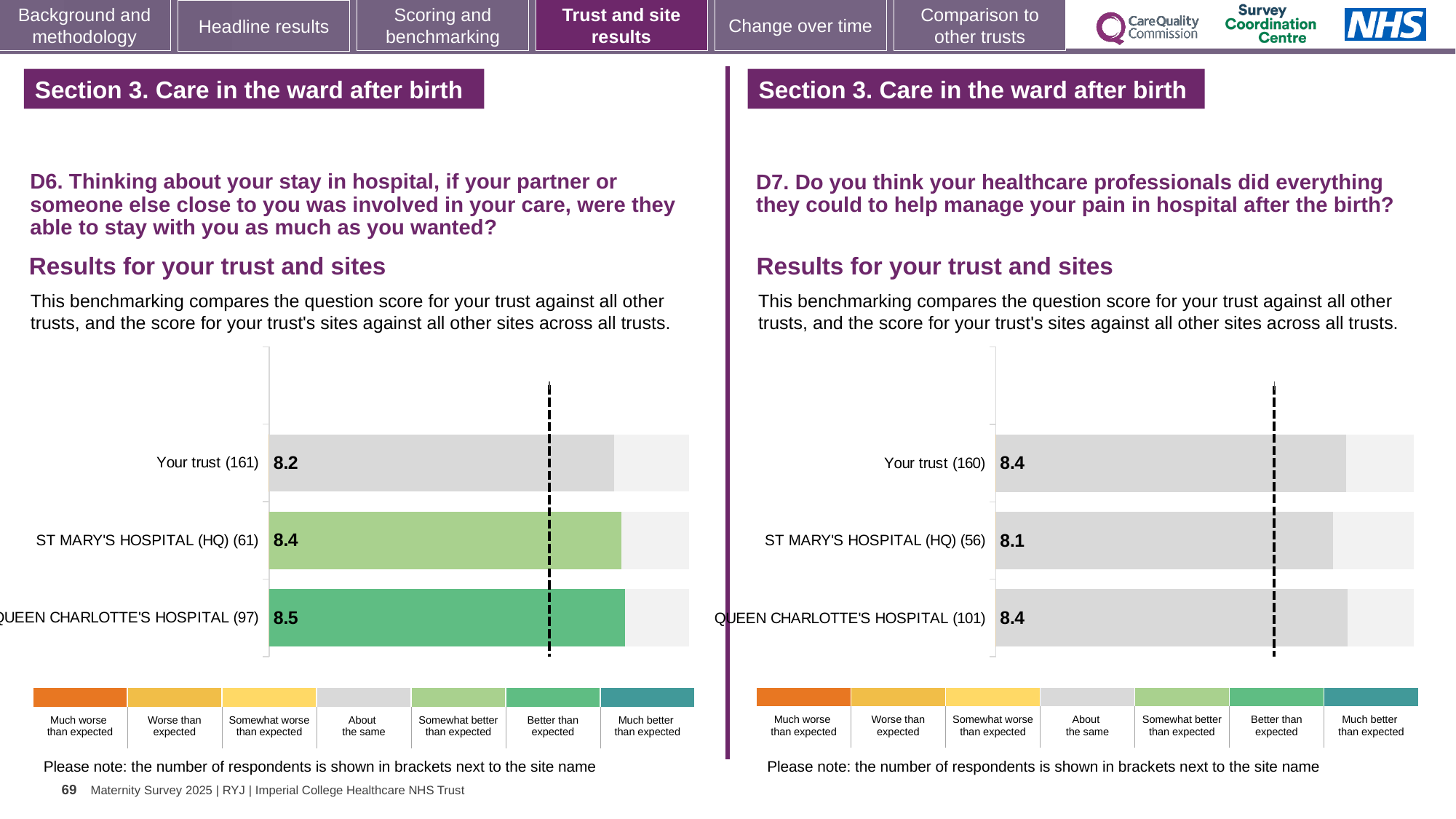
On the D7 chart (right), what is the difference between the scores for Your trust and ST MARY'S HOSPITAL (HQ)? 0.3 What type of chart is used on the D7 chart (right)? Bar chart On the D7 chart (right), what is the score for Your trust? 8.4 On the D6 chart (left), what is the score for QUEEN CHARLOTTE'S HOSPITAL? 8.5 On the D6 chart (left), which site or trust has the lowest score? Your trust On the D6 chart (left), how many bars are plotted? 3 On the D6 chart (left), which site or trust has the highest score? QUEEN CHARLOTTE'S HOSPITAL Which is larger: the score for ST MARY'S HOSPITAL (HQ) on the D6 chart (left) or on the D7 chart (right)? D6 chart (left) On the D6 chart (left), what is the score for Your trust? 8.2 On the D7 chart (right), which site or trust has the lowest score? ST MARY'S HOSPITAL (HQ) On the D7 chart (right), what is the score for ST MARY'S HOSPITAL (HQ)? 8.1 On the D6 chart (left), what is the difference between the scores for QUEEN CHARLOTTE'S HOSPITAL and Your trust? 0.3